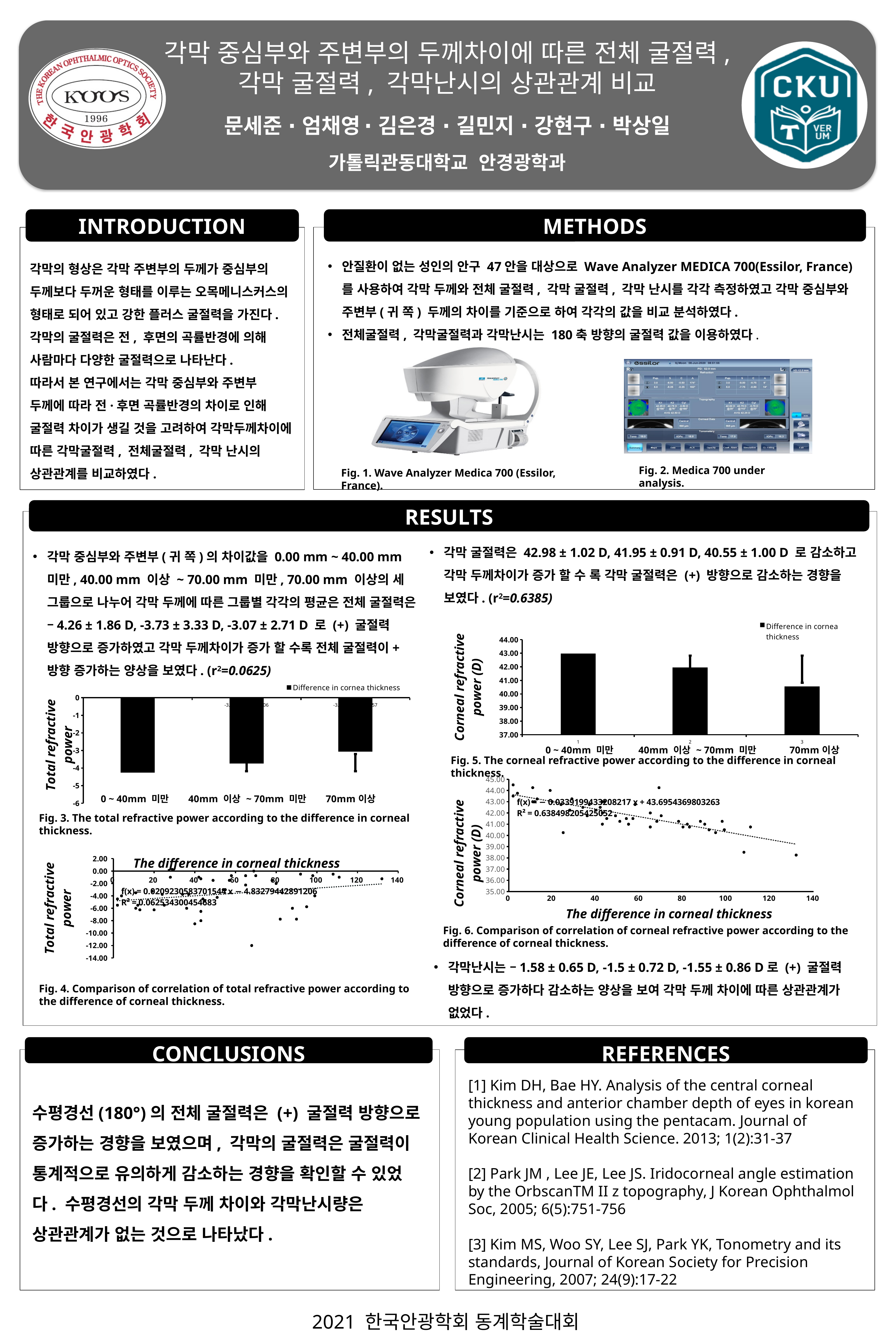
In Fig. 5 (corneal refractive power bar chart), is the value for 70mm 이상 greater or less than 41.00? less In Fig. 3 (total refractive power bar chart), which category has the lowest (most negative) bar? 0 ~ 40mm 미만 In Fig. 5 (corneal refractive power bar chart), is the value for 0 ~ 40mm 미만 greater or less than 42.00? greater How many series does the legend of Fig. 5 (corneal refractive power chart) list? 1 In Fig. 5 (corneal refractive power bar chart), which category has the lowest bar? 70mm 이상 In Fig. 3 (total refractive power bar chart), is the value for 0 ~ 40mm 미만 greater or less than -4? less What kind of chart is Fig. 6 (corneal refractive power vs. difference in corneal thickness)? scatter chart In Fig. 5 (corneal refractive power bar chart), which category has the highest bar? 0 ~ 40mm 미만 How many categories are shown on the x axis of Fig. 3 (total refractive power bar chart)? 3 What R² value is printed on Fig. 6 (corneal refractive power scatter chart)? 0.638498205425052 In Fig. 5 (corneal refractive power bar chart), do the bar values rise or fall from left to right along the x axis? fall